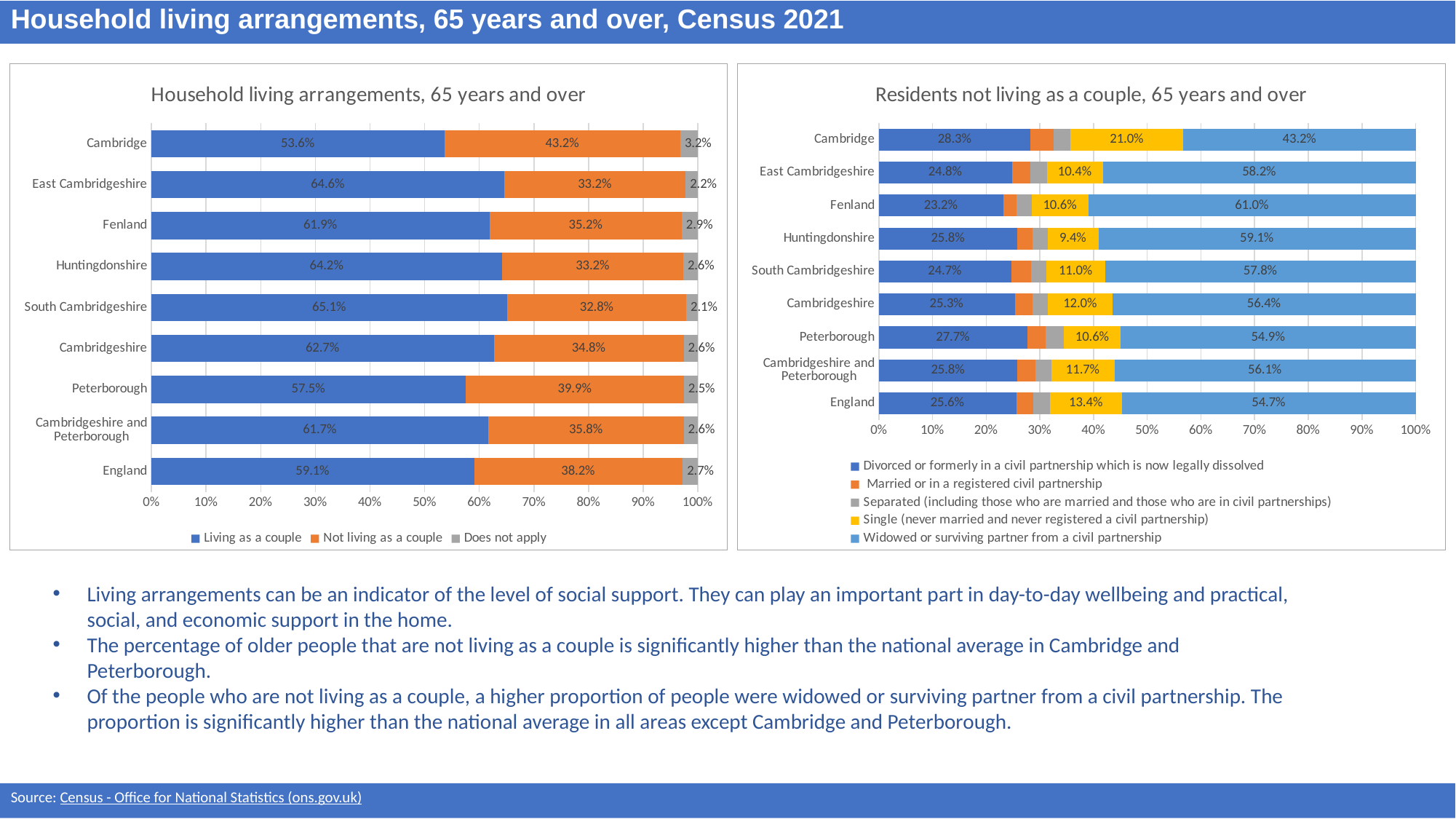
In the 'Household living arrangements, 65 years and over' chart, how many series does the legend list? 3 In the 'Residents not living as a couple, 65 years and over' chart, what is the 'Widowed or surviving partner from a civil partnership' value for Fenland? 61.0% In the 'Household living arrangements, 65 years and over' chart, which area has the lowest 'Living as a couple' percentage? Cambridge In the 'Residents not living as a couple, 65 years and over' chart, which area has the lowest 'Widowed or surviving partner from a civil partnership' percentage? Cambridge In the 'Residents not living as a couple, 65 years and over' chart, what is the 'Single (never married and never registered a civil partnership)' value for Cambridge? 21.0% What type of chart is the 'Residents not living as a couple, 65 years and over' chart? Stacked bar chart In the 'Residents not living as a couple, 65 years and over' chart, is the 'Divorced or formerly in a civil partnership which is now legally dissolved' value for Peterborough larger or smaller than that for Fenland? larger In the 'Household living arrangements, 65 years and over' chart, which area has the highest 'Living as a couple' percentage? South Cambridgeshire In the 'Household living arrangements, 65 years and over' chart, what is the difference between the 'Not living as a couple' values for Cambridge and England? 5.0% In the 'Household living arrangements, 65 years and over' chart, what percentage of residents in Cambridge are living as a couple? 53.6% In the 'Residents not living as a couple, 65 years and over' chart, how many areas are shown? 9 In the 'Household living arrangements, 65 years and over' chart, what is the 'Not living as a couple' value for Peterborough? 39.9%